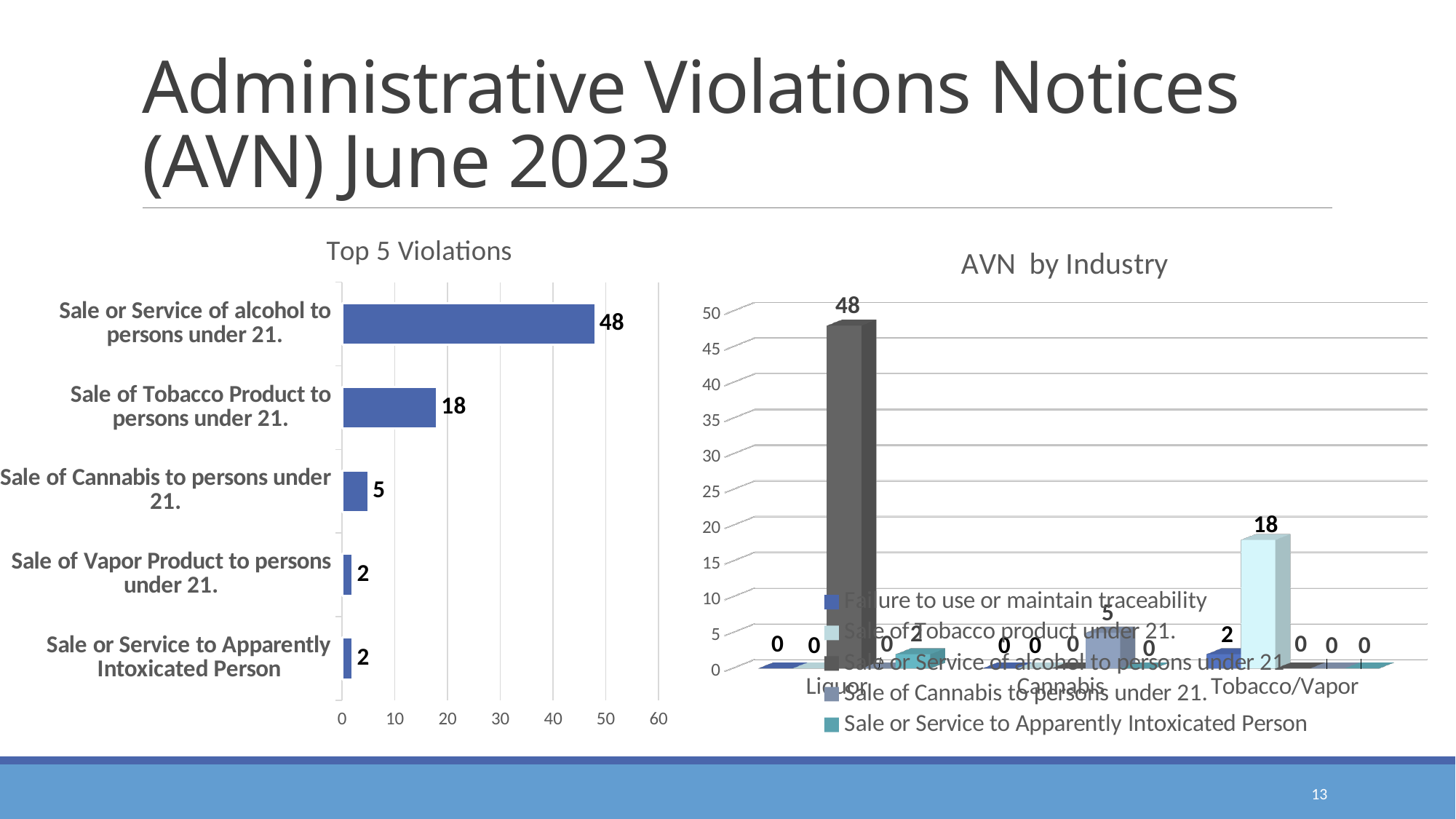
In the Top 5 Violations chart, what is the value for Sale of Tobacco Product to persons under 21? 18 What kind of chart is the Top 5 Violations chart? Bar chart In the AVN by Industry chart, what is the value for Sale of Tobacco product under 21 in the Tobacco/Vapor industry? 18 How many industry categories are shown on the x axis of the AVN by Industry chart? 3 In the Top 5 Violations chart, which is larger: the value for Sale of Cannabis to persons under 21 or the value for Sale of Vapor Product to persons under 21? Sale of Cannabis to persons under 21. In the AVN by Industry chart, what is the value for Sale or Service of alcohol to persons under 21 in the Liquor industry? 48 How many violation categories are shown in the Top 5 Violations chart? 5 In the AVN by Industry chart, what is the value for Sale of Cannabis to persons under 21 in the Cannabis industry? 5 How many series does the legend of the AVN by Industry chart list? 5 In the Top 5 Violations chart, which violation has the highest value? Sale or Service of alcohol to persons under 21. In the Top 5 Violations chart, what is the difference between the values for Sale or Service of alcohol to persons under 21 and Sale of Tobacco Product to persons under 21? 30 In the Top 5 Violations chart, what is the value for Sale or Service of alcohol to persons under 21? 48